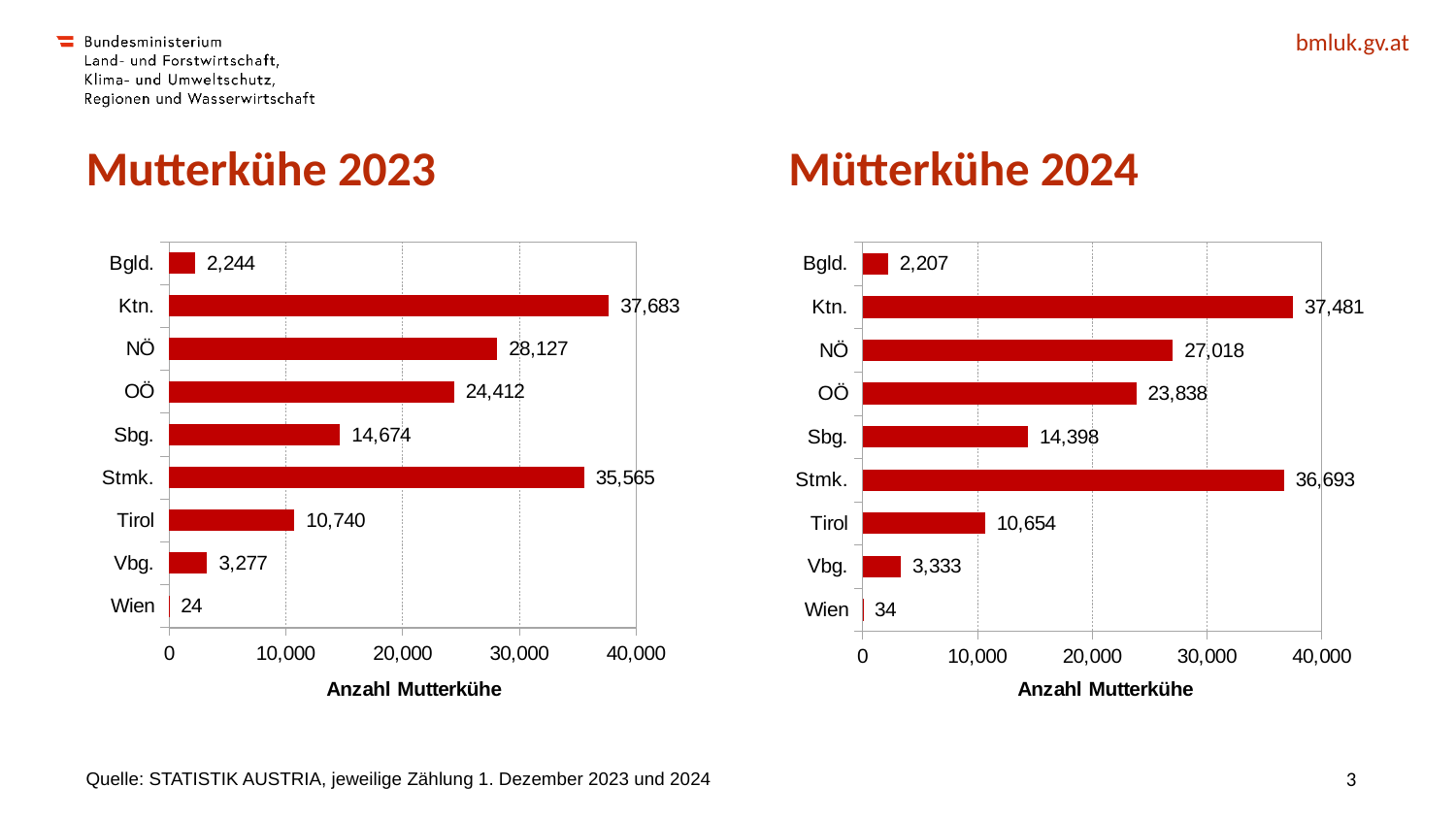
In the Mutterkühe 2023 chart, which category has the highest value? Ktn. In the Mütterkühe 2024 chart, what is the value for Stmk.? 36,693 How many categories are shown in the Mütterkühe 2024 chart? 9 In the Mütterkühe 2024 chart, what is the difference between the values for Ktn. and Stmk.? 788 What is the x-axis title of the Mutterkühe 2023 chart? Anzahl Mutterkühe In the Mutterkühe 2023 chart, is the value for Stmk. greater or less than 30,000? greater In the Mutterkühe 2023 chart, what is the difference between the values for NÖ and OÖ? 3,715 In the Mutterkühe 2023 chart, what is the value for Ktn.? 37,683 What kind of chart is the Mutterkühe 2023 chart? bar chart In the Mütterkühe 2024 chart, what is the value for Vbg.? 3,333 In the Mütterkühe 2024 chart, which is larger, the value for Sbg. or the value for Tirol? Sbg. In the Mütterkühe 2024 chart, which category has the lowest value? Wien